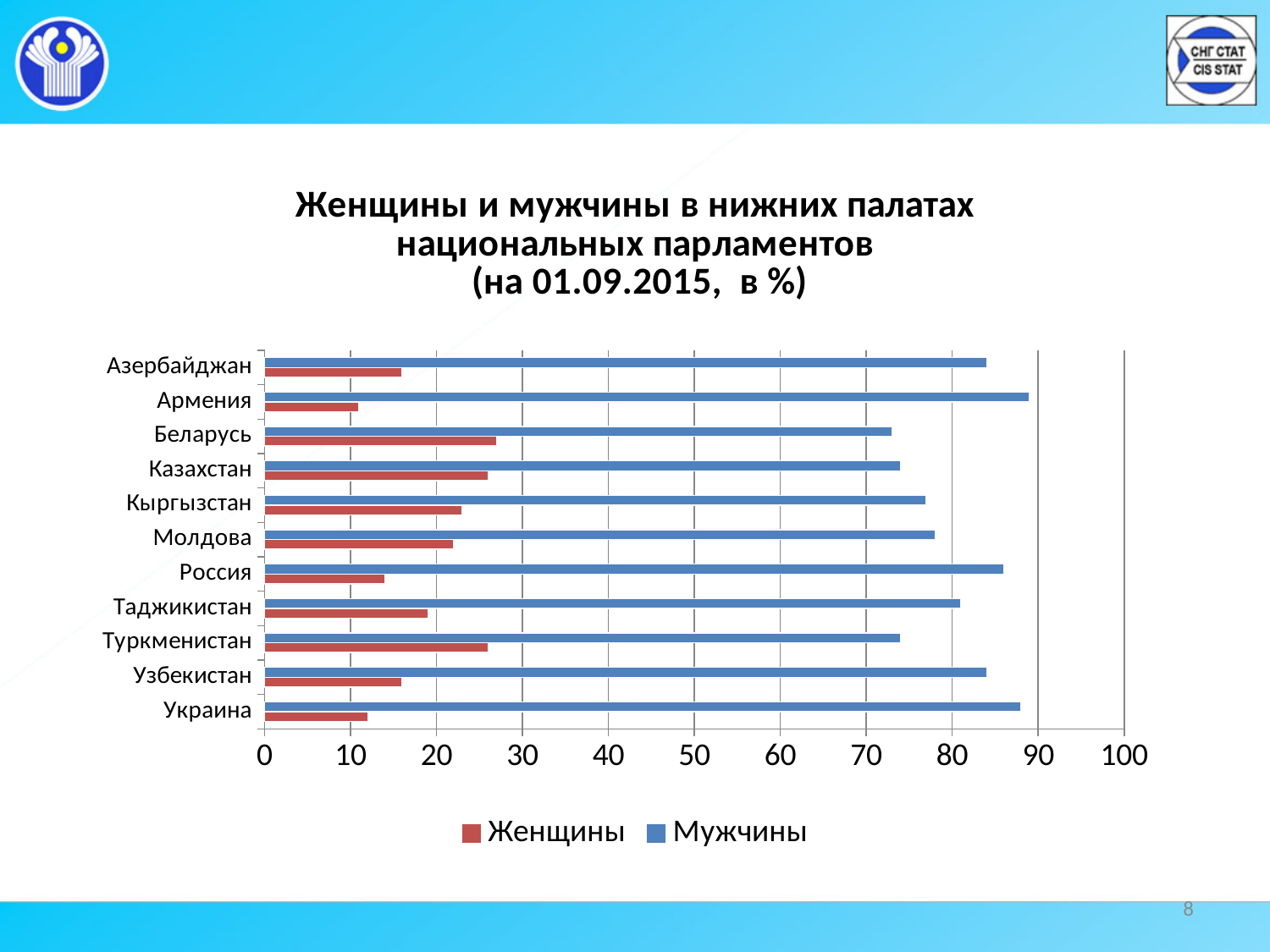
Which is larger, the Женщины value for Беларусь or the Женщины value for Россия? Беларусь Is the value for Женщины in Украина greater or less than 20? less Is the value for Мужчины in Таджикистан greater or less than 80? greater What kind of chart is shown on the slide? bar chart What are the two series named in the legend? Женщины and Мужчины How many series does the legend list? 2 Which is larger, the Мужчины value for Россия or the Мужчины value for Беларусь? Россия How many countries are shown on the chart? 11 Is the value for Женщины in Беларусь greater or less than 20? greater